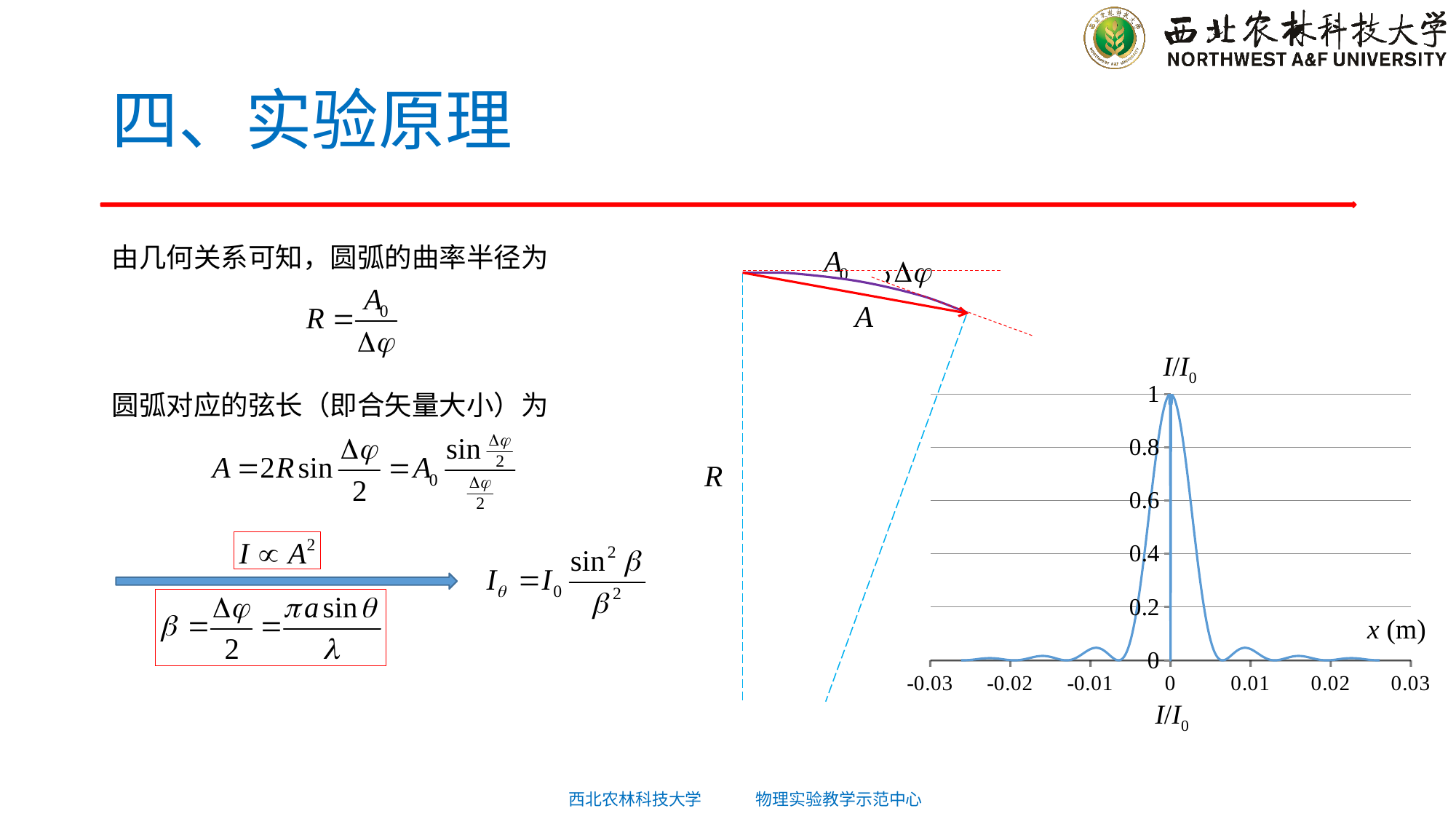
What is the label of the vertical axis of the chart? I/I0 Overall, does the curve rise or fall as x goes from -0.01 to 0? rise At which value of x does the curve reach its highest value of I/I0? 0 What kind of chart is shown on the right of the slide? line chart Which is larger, the value of I/I0 at x = 0 or at x = 0.01? x = 0 What is the label of the x axis of the chart? x (m) Overall, does the curve rise or fall as x goes from 0 to 0.01? fall Is the value of I/I0 at x = 0.01 greater or less than 0.2? less What is the value of I/I0 at x = 0? 1 Is the value of I/I0 at x = -0.02 greater or less than 0.2? less How many tick labels are shown on the x axis of the chart? 7 Is the value of I/I0 at x = 0 greater or less than 0.8? greater